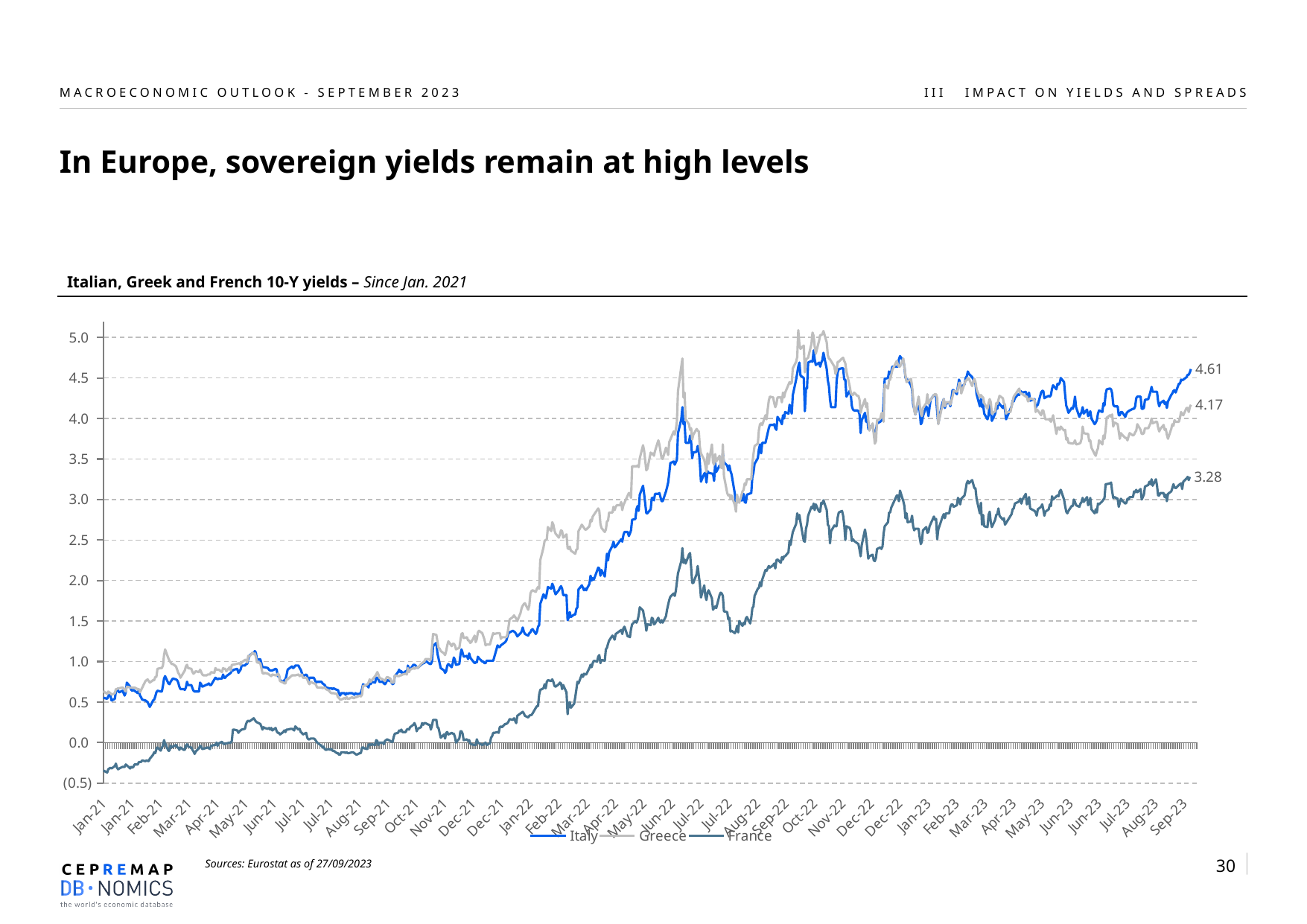
Do the yields overall rise or fall from Jan-21 to Sep-23? Rise What is the latest value shown for Greece's 10-year yield (Sep-23)? 4.17 Which country has the highest 10-year yield at the end of the series (Sep-23)? Italy Which country has the lowest 10-year yield at the end of the series (Sep-23)? France How many series does the legend list? 3 What is the difference between the latest Italian and Greek 10-year yields? 0.44 What kind of chart is shown on the slide? Line chart Is the value for France in Jan-21 greater or less than 0.0? less What is the difference between the latest Italian and French 10-year yields? 1.33 At the end of the series, is the Italian yield or the Greek yield larger? Italy What is the latest value shown for Italy's 10-year yield (Sep-23)? 4.61 What is the latest value shown for France's 10-year yield (Sep-23)? 3.28